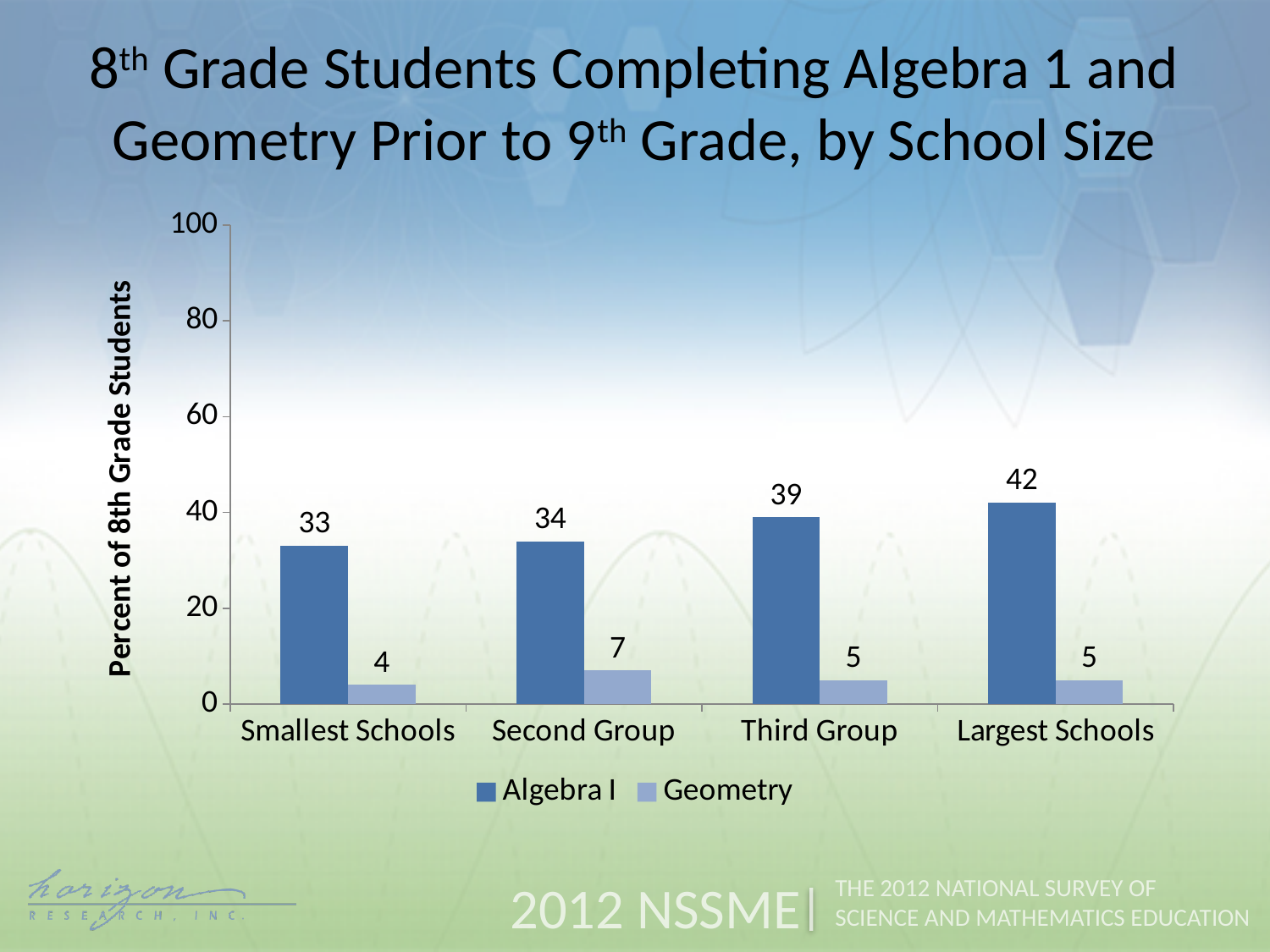
What is the Algebra I value for Smallest Schools? 33 How many series does the legend list? 2 Do the Algebra I values rise or fall from Smallest Schools to Largest Schools? rise How many school size groups are shown on the x axis? 4 What kind of chart is shown on the slide? bar chart What is the Algebra I value for Largest Schools? 42 Which school size group has the lowest Geometry value? Smallest Schools Which is larger, the Algebra I value for Third Group or for Second Group? Third Group What is the difference between the Algebra I values for Largest Schools and Smallest Schools? 9 Is the Algebra I value for Third Group greater or less than 20? greater Which school size group has the highest Algebra I value? Largest Schools What is the Geometry value for Second Group? 7